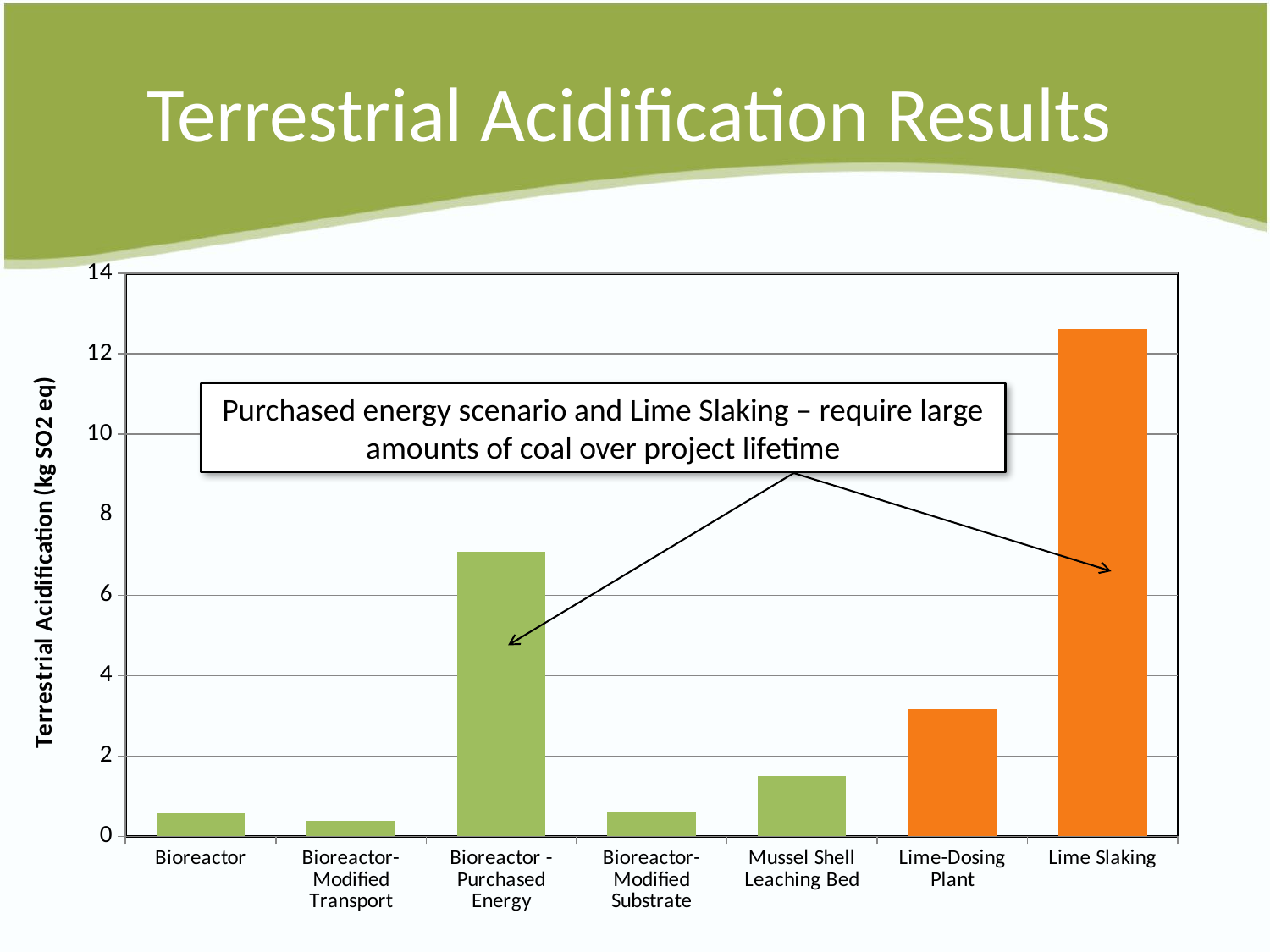
How many categories are plotted on the x axis? 7 Is the value for Mussel Shell Leaching Bed greater or less than 2? less Is the value for Lime Slaking greater or less than 12? greater Which category has the highest terrestrial acidification value? Lime Slaking Which is larger, the value for Lime-Dosing Plant or the value for Mussel Shell Leaching Bed? Lime-Dosing Plant Is the value for Bioreactor - Purchased Energy greater or less than 6? greater What kind of chart is shown on the slide? bar chart What is the label on the y axis? Terrestrial Acidification (kg SO2 eq) Which category has the lowest terrestrial acidification value? Bioreactor-Modified Transport What colour are the bars for Lime-Dosing Plant and Lime Slaking? orange